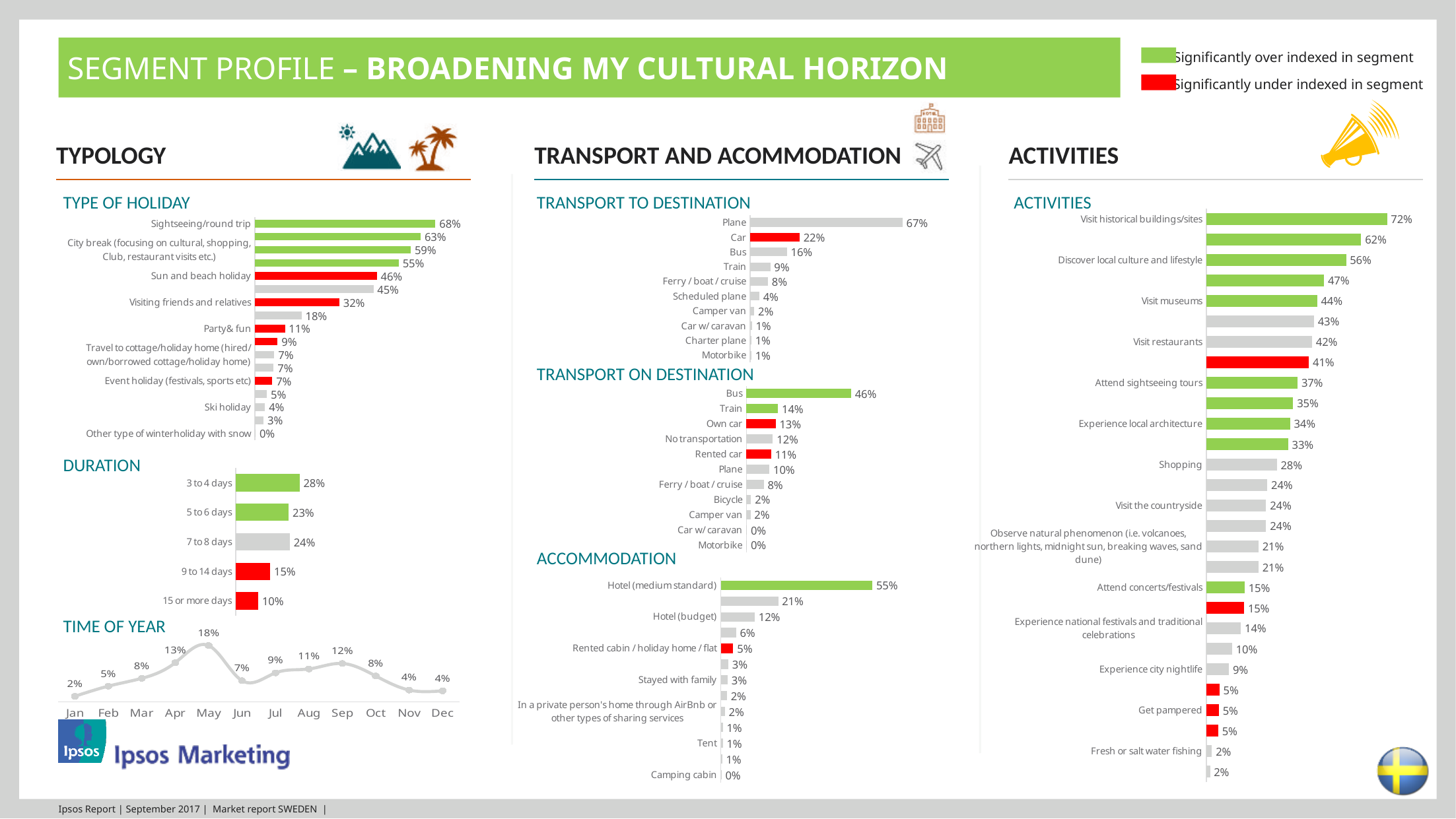
In the Transport on Destination chart, what is the difference between Bus and Train? 32% In the Accommodation chart, what is the value for Hotel (medium standard)? 55% In the Time of Year chart, which month has the highest value? May In the Time of Year chart, what is the value for January? 2% In the Type of Holiday chart, what is the value for Sun and beach holiday (the red bar)? 46% In the Activities chart, which activity has the highest value? Visit historical buildings/sites In the Duration chart, which is larger: 3 to 4 days or 7 to 8 days? 3 to 4 days What type of chart is the Time of Year chart? Line chart How many months are plotted in the Time of Year chart? 12 In the Transport to Destination chart, what is the value for Plane? 67% In the Duration chart, what is the value for 9 to 14 days? 15% In the Activities chart, what is the value for Visit museums? 44%